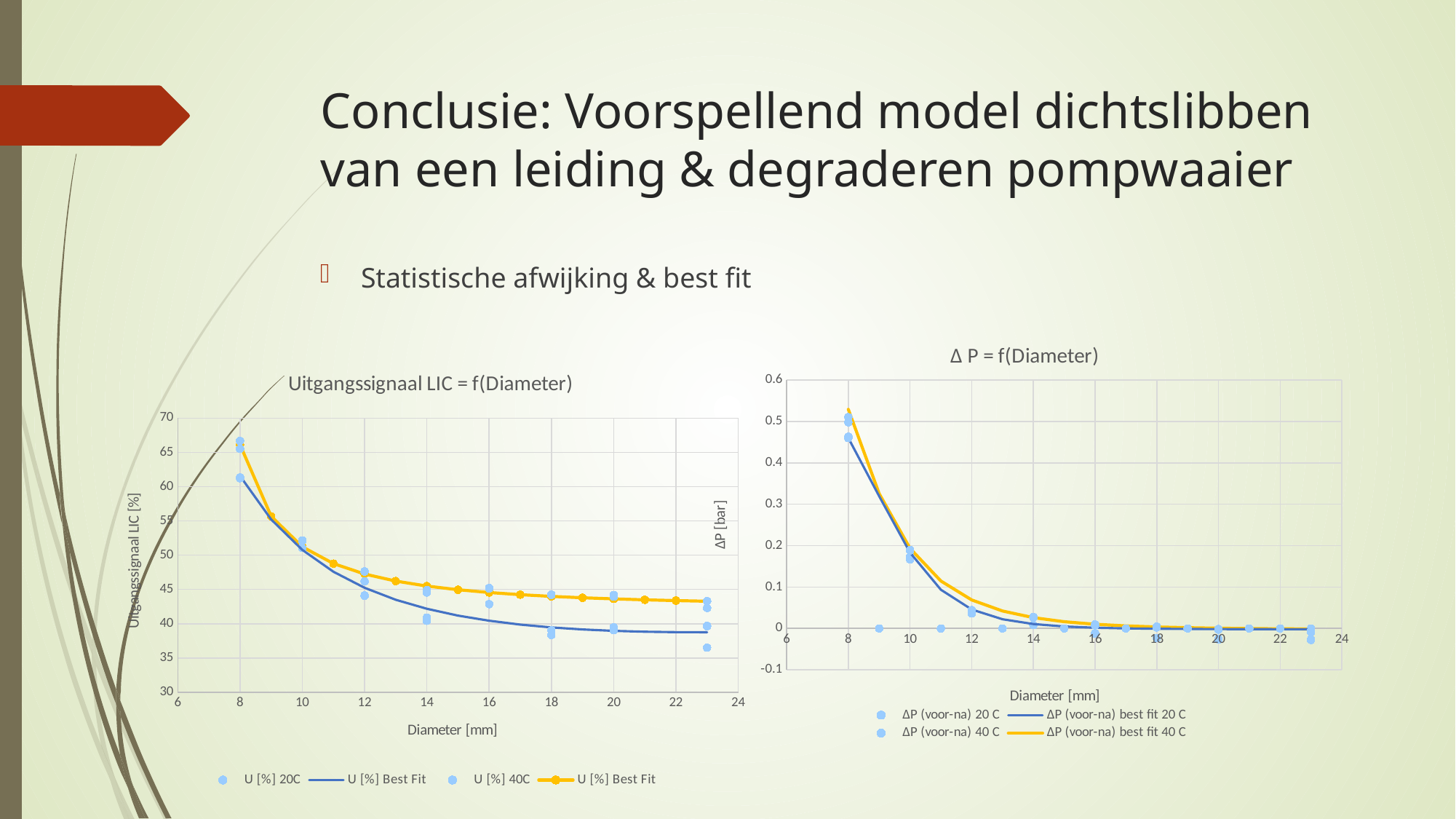
In the chart titled 'Uitgangssignaal LIC = f(Diameter)', is the value of the blue 'U [%] Best Fit' line at a diameter of 20 mm greater or less than 40? less What is the title of the chart on the left of the slide? Uitgangssignaal LIC = f(Diameter) In the chart titled 'Δ P = f(Diameter)', is the value of the 'ΔP (voor-na) best fit 20 C' line at a diameter of 8 mm greater or less than 0.4? greater In the chart titled 'Uitgangssignaal LIC = f(Diameter)', is the value of the yellow 'U [%] Best Fit' line at a diameter of 8 mm greater or less than 60? greater In the chart titled 'Uitgangssignaal LIC = f(Diameter)', at a diameter of 16 mm, which best-fit line is higher: the yellow one or the blue one? the yellow one In the chart titled 'Uitgangssignaal LIC = f(Diameter)', do the values rise or fall as the diameter increases? fall What is the title of the chart on the right of the slide? Δ P = f(Diameter) In the chart titled 'Uitgangssignaal LIC = f(Diameter)', how many series does the legend list? 4 In the chart titled 'Uitgangssignaal LIC = f(Diameter)', what kind of chart is shown? scatter chart with best-fit lines In the chart titled 'Δ P = f(Diameter)', how many series does the legend list? 4 In the chart titled 'Δ P = f(Diameter)', do the ΔP values rise or fall as the diameter increases? fall